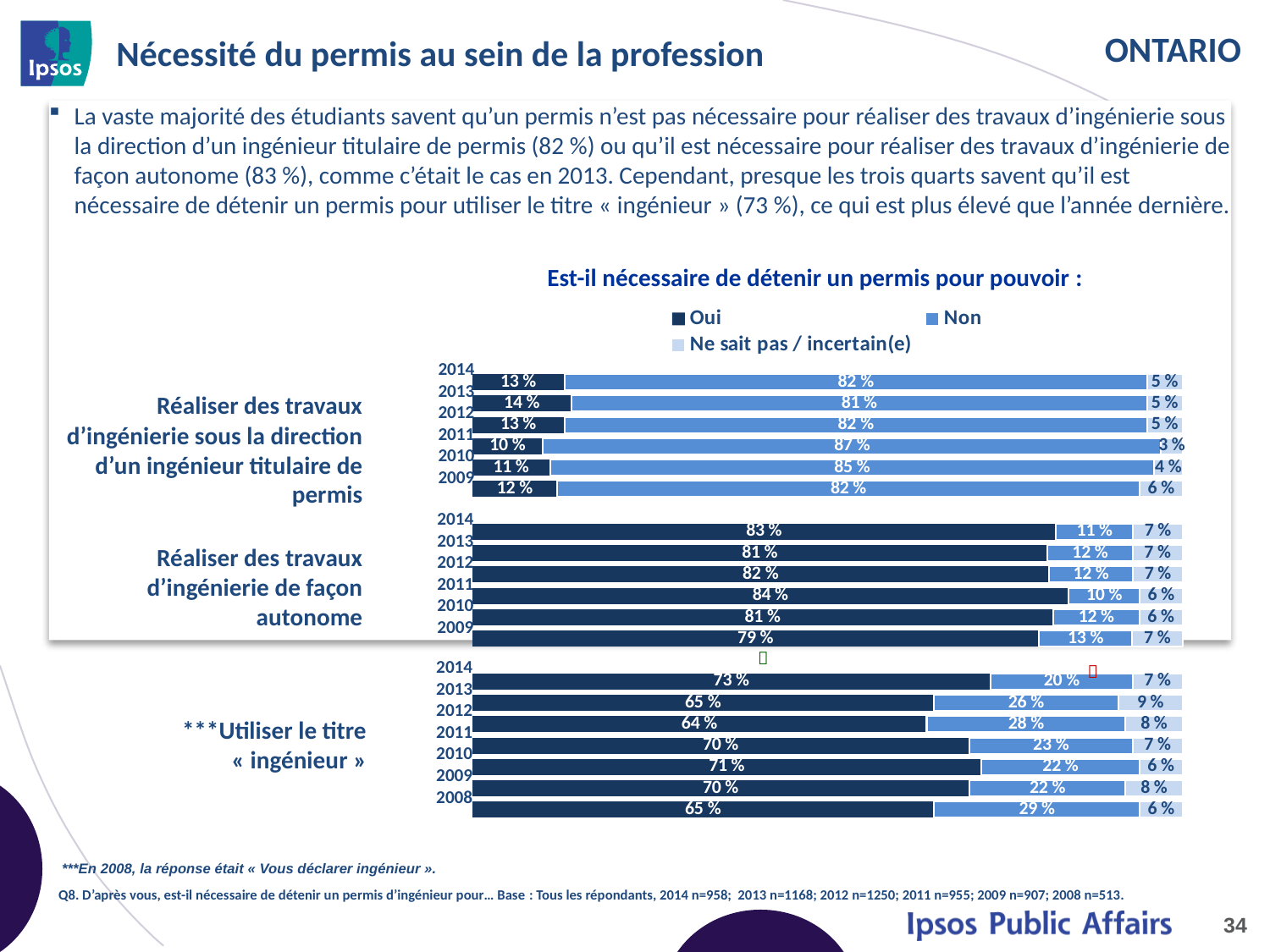
For 'Réaliser des travaux d'ingénierie de façon autonome', is the 'Oui' value for 2014 larger or smaller than the 'Oui' value for 2009? Larger For 'Utiliser le titre « ingénieur »', what is the difference between the 'Oui' values for 2014 and 2013? 8 % How many series does the chart legend list? 3 What is the title of the chart? Est-il nécessaire de détenir un permis pour pouvoir : For 'Utiliser le titre « ingénieur »', which year has the lowest 'Oui' value? 2012 What is the 'Ne sait pas / incertain(e)' value for 2013 for 'Utiliser le titre « ingénieur »'? 9 % How many years are shown for 'Utiliser le titre « ingénieur »'? 7 What kind of chart is shown on the slide? Stacked bar chart What is the total of the 2014 stacked bar for 'Réaliser des travaux d'ingénierie sous la direction d'un ingénieur titulaire de permis'? 100 % For 'Réaliser des travaux d'ingénierie de façon autonome', which year has the highest 'Oui' value? 2011 What is the 'Non' value for 2011 for 'Réaliser des travaux d'ingénierie sous la direction d'un ingénieur titulaire de permis'? 87 % What is the 'Oui' value for 2014 for 'Utiliser le titre « ingénieur »'? 73 %